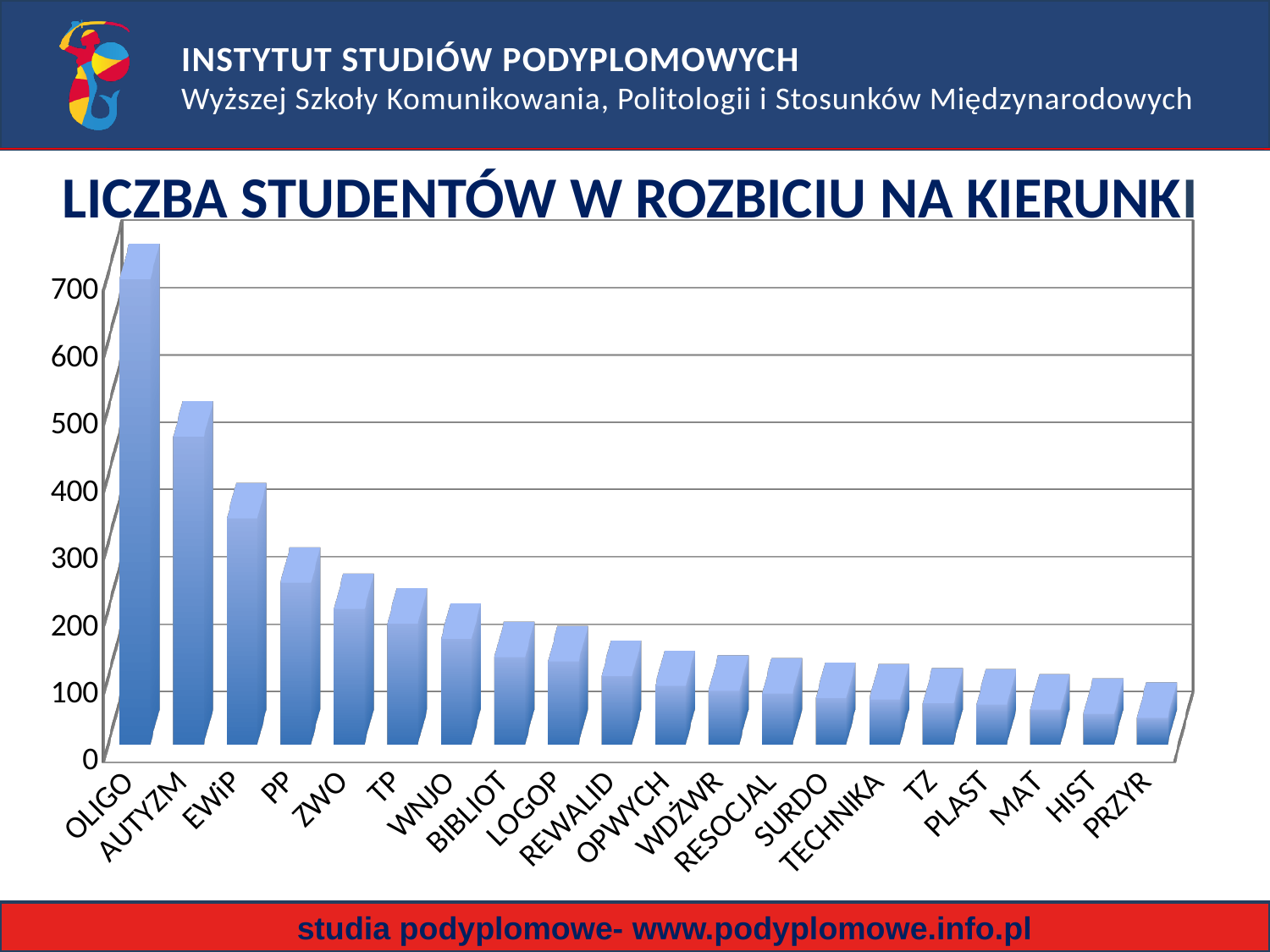
Which has more students, EWiP or PP? EWiP Is the value for OLIGO greater or less than 600? greater Is the value for PP greater or less than 400? less Is the value for AUTYZM greater or less than 400? greater How many categories (kierunki) are shown on the x axis of the chart? 20 Do the values rise or fall moving from left to right along the x axis? fall Which category has the highest number of students? OLIGO Which has more students, OLIGO or AUTYZM? OLIGO Which category has the lowest number of students? PRZYR What kind of chart is shown on the slide? bar chart What is the title of the chart? LICZBA STUDENTÓW W ROZBICIU NA KIERUNKI